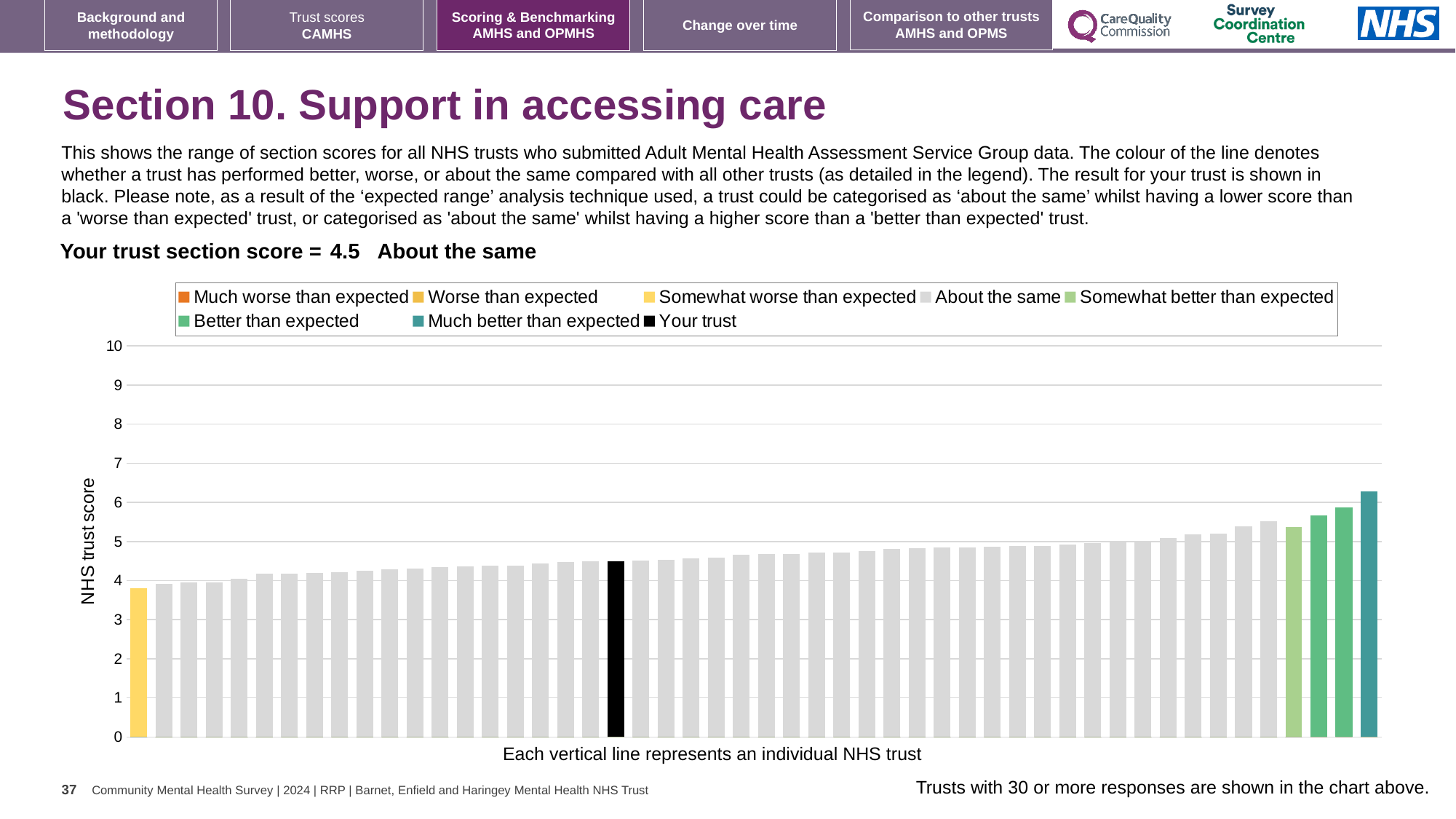
Is the value for your trust (the black bar) greater or less than 5? less Is the value of the leftmost bar greater or less than 4? less Which legend category does the tallest bar belong to? Much better than expected Is the value for your trust (the black bar) greater or less than 4? greater How many bars are coloured teal (Much better than expected)? 1 What is the label on the y axis of the chart? NHS trust score What is the section score for your trust? 4.5 What kind of chart is shown on the slide? bar chart Is the leftmost bar higher or lower than the black bar for your trust? lower Do the bar values rise or fall from left to right along the x axis? rise How many entries does the chart legend list? 8